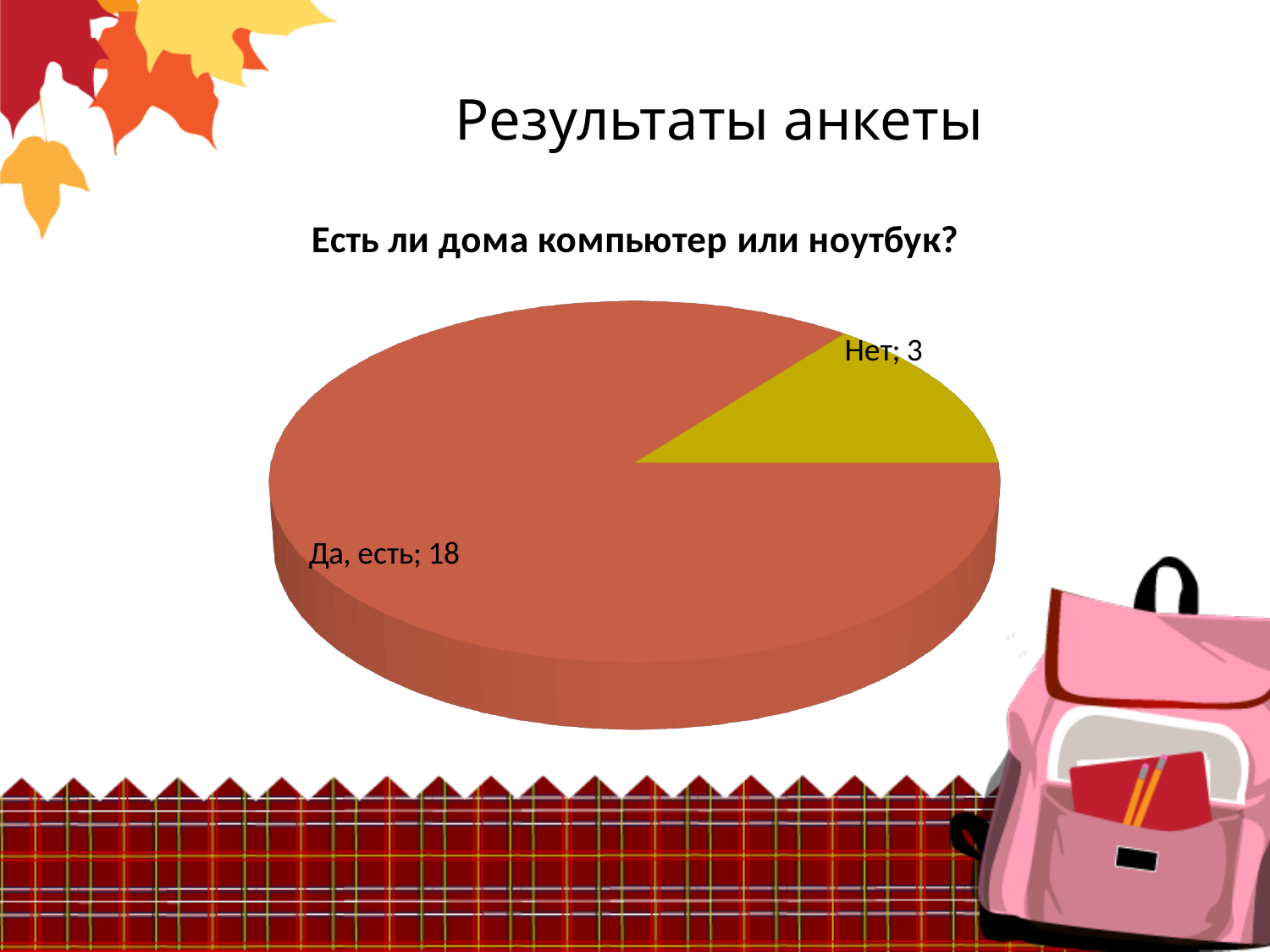
Which is larger, the value for "Да, есть" or the value for "Нет"? Да, есть What colour is the "Нет" slice? yellow What is the difference between the values for "Да, есть" and "Нет"? 15 How many slices does the pie chart have? 2 Which category has the largest slice? Да, есть What kind of chart is shown on the slide? pie chart What is the value for "Да, есть"? 18 Which category has the smallest slice? Нет What is the title of the chart? Есть ли дома компьютер или ноутбук? What is the value for "Нет"? 3 What is the total of all slices in the pie chart? 21